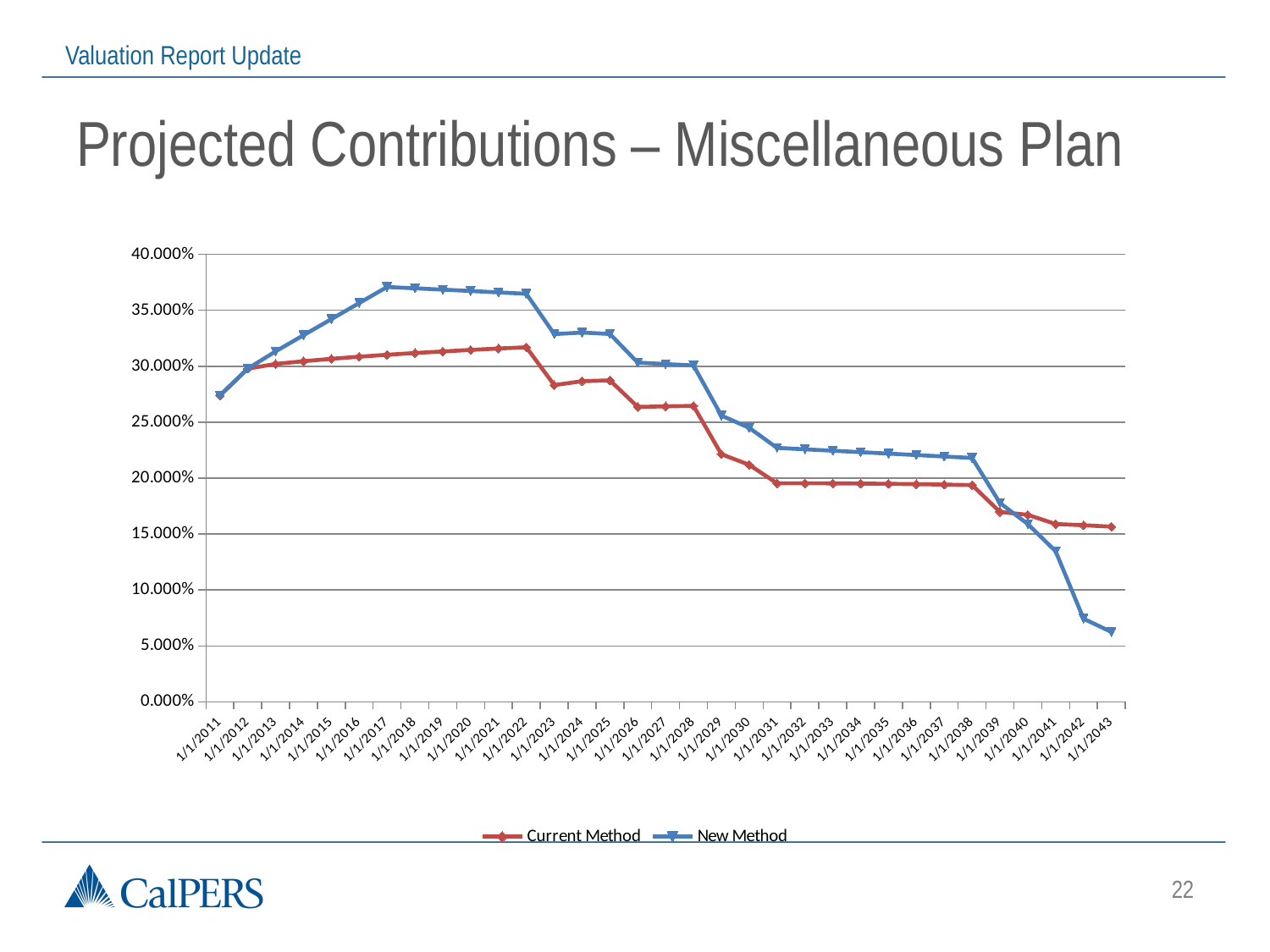
How many series does the legend list? 2 At 1/1/2043, which series has the higher value, Current Method or New Method? Current Method On which date does the New Method series reach its lowest value? 1/1/2043 What kind of chart is shown on the slide? Line chart What is the title of the slide's chart section? Projected Contributions – Miscellaneous Plan Is the New Method value for 1/1/2017 greater or less than 35.000%? greater Is the Current Method value for 1/1/2029 greater or less than 20.000%? greater How many dates are plotted along the x axis? 33 At 1/1/2017, which series has the higher value, Current Method or New Method? New Method Is the New Method value for 1/1/2043 greater or less than 10.000%? less What are the two series named in the legend? Current Method and New Method